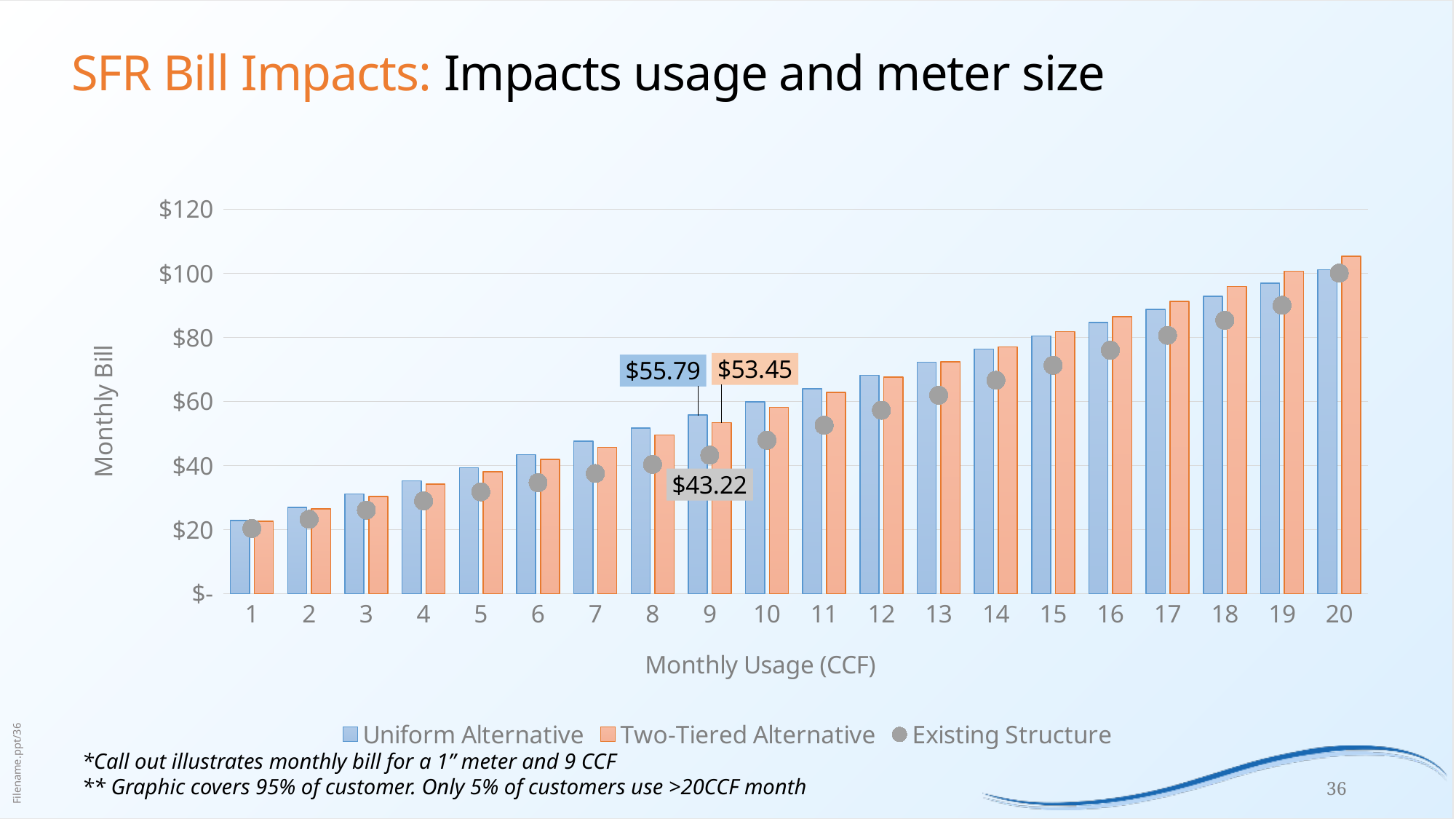
At 9 CCF, how much higher is the Uniform Alternative bill than the Two-Tiered Alternative bill? $2.34 How many monthly usage levels (CCF) are shown on the x axis? 20 What is the title of the x axis? Monthly Usage (CCF) What is the Uniform Alternative monthly bill at 9 CCF of monthly usage? $55.79 How many series does the legend list? 3 At 9 CCF, what is the difference between the Uniform Alternative bill and the Existing Structure bill? $12.57 Is the Two-Tiered Alternative bill at 20 CCF greater or less than $100? greater At 9 CCF, which is larger: the Uniform Alternative bill or the Two-Tiered Alternative bill? Uniform Alternative What is the Two-Tiered Alternative monthly bill at 9 CCF of monthly usage? $53.45 Is the Existing Structure bill at 10 CCF greater or less than $60? less What is the Existing Structure monthly bill at 9 CCF of monthly usage? $43.22 Do the monthly bills rise or fall as monthly usage increases? rise